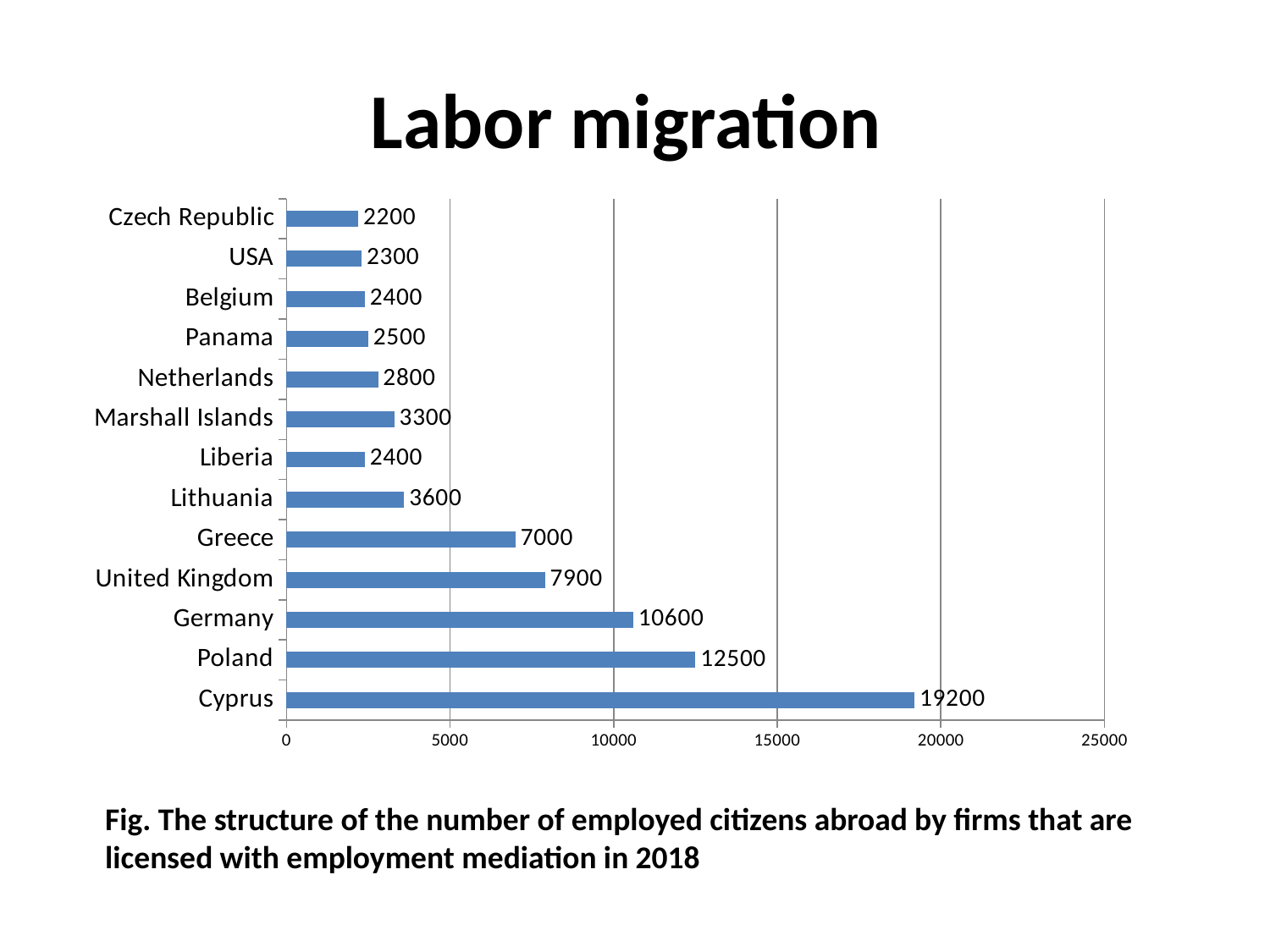
Which country has the highest value? Cyprus What is the title of the slide? Labor migration What is the value for Cyprus? 19200 Which is larger, the value for Lithuania or the value for Netherlands? Lithuania What is the value for Germany? 10600 What is the difference between the values for Poland and Germany? 1900 What is the value for Marshall Islands? 3300 Which country has the lowest value? Czech Republic How many countries are shown in the chart? 13 What is the difference between the values for United Kingdom and Greece? 900 Is the value for Poland greater or less than 10000? greater What kind of chart is shown on the slide? Bar chart